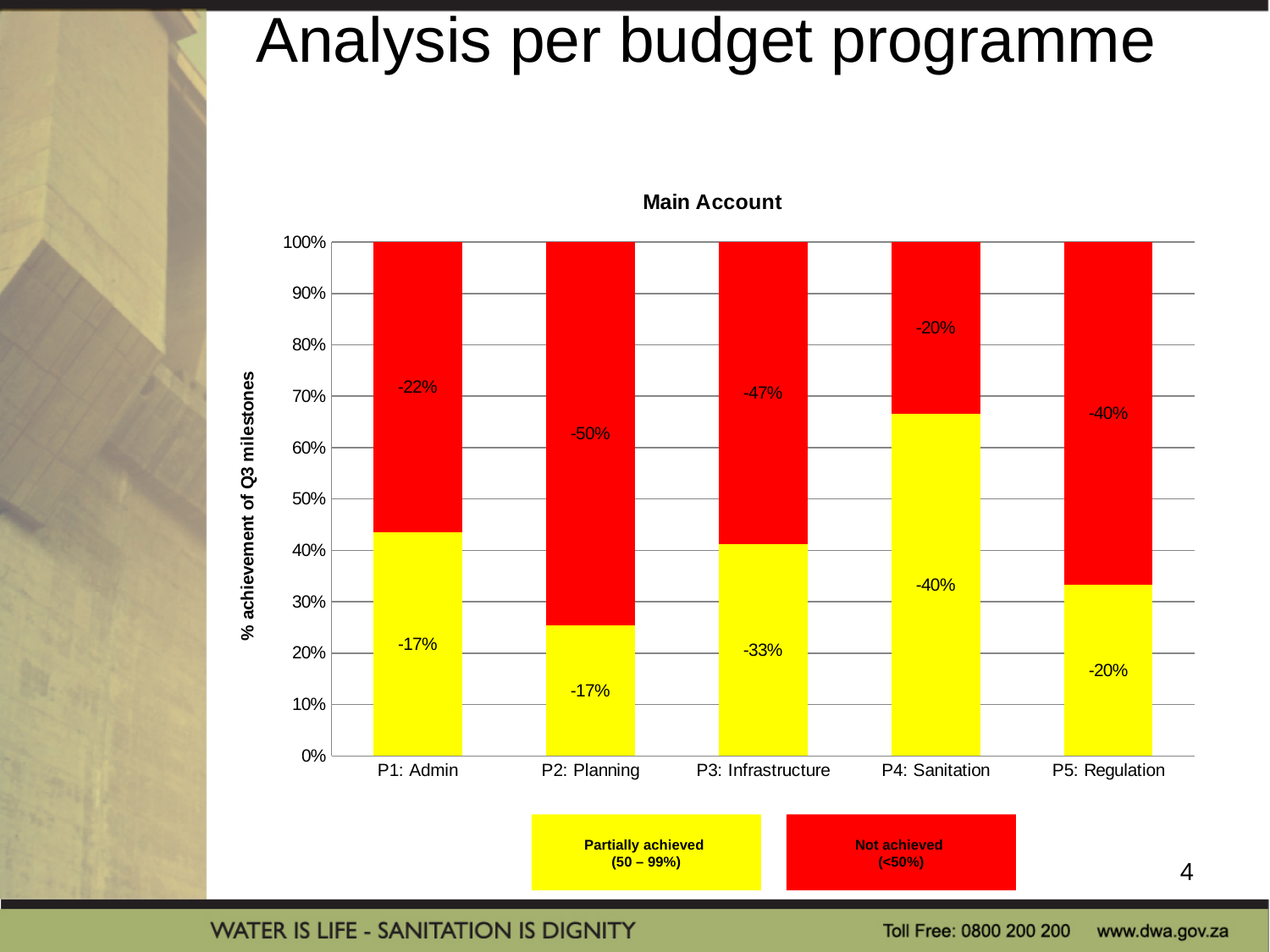
What is the title of the chart? Main Account How many budget programmes (categories) are shown on the x axis? 5 What data label is printed on the yellow (Partially achieved) segment for P5: Regulation? -20% What type of chart is shown on the slide? Stacked bar chart What data label is printed on the red (Not achieved) segment for P2: Planning? -50% Is the top of the yellow (Partially achieved) segment for P4: Sanitation greater or less than 60%? greater Which budget programme has the tallest yellow (Partially achieved) segment? P4: Sanitation How many series does the legend list? 2 What is the label on the vertical axis? % achievement of Q3 milestones What data label is printed on the yellow (Partially achieved) segment for P1: Admin? -17% What data label is printed on the red (Not achieved) segment for P3: Infrastructure? -47% Which budget programme has the shortest yellow (Partially achieved) segment? P2: Planning